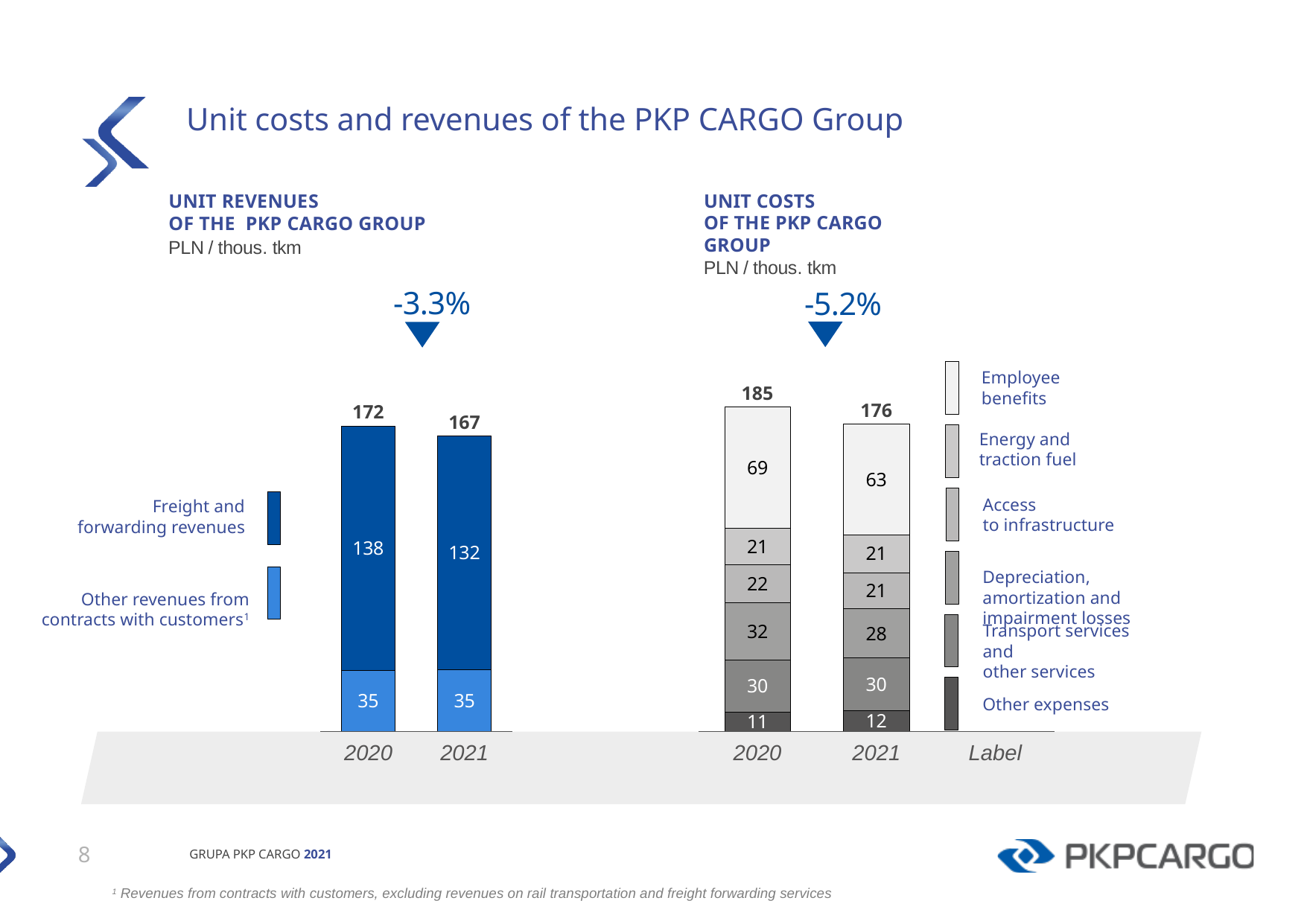
In the Unit revenues chart, what is the value of Freight and forwarding revenues in 2020? 138 In the Unit costs chart, what is the value of Employee benefits in 2021? 63 In the Unit revenues chart, what is the total unit revenue for 2021? 167 In the Unit revenues chart, by how much did Freight and forwarding revenues fall from 2020 to 2021? 6 In the Unit costs chart, what is the difference between the 2020 and 2021 totals? 9 In the Unit revenues chart, what is the value of Other revenues from contracts with customers in 2021? 35 In the Unit costs chart, what is the total unit cost for 2020? 185 In the Unit costs chart, which cost component is the largest in 2020? Employee benefits In the Unit costs chart, how many cost components does the legend list? 6 In the Unit revenues chart, what percentage change is shown between 2020 and 2021? -3.3% In the Unit costs chart, which cost component is the smallest in 2021? Other expenses What type of chart is used to show unit costs of the PKP CARGO Group? Stacked bar chart